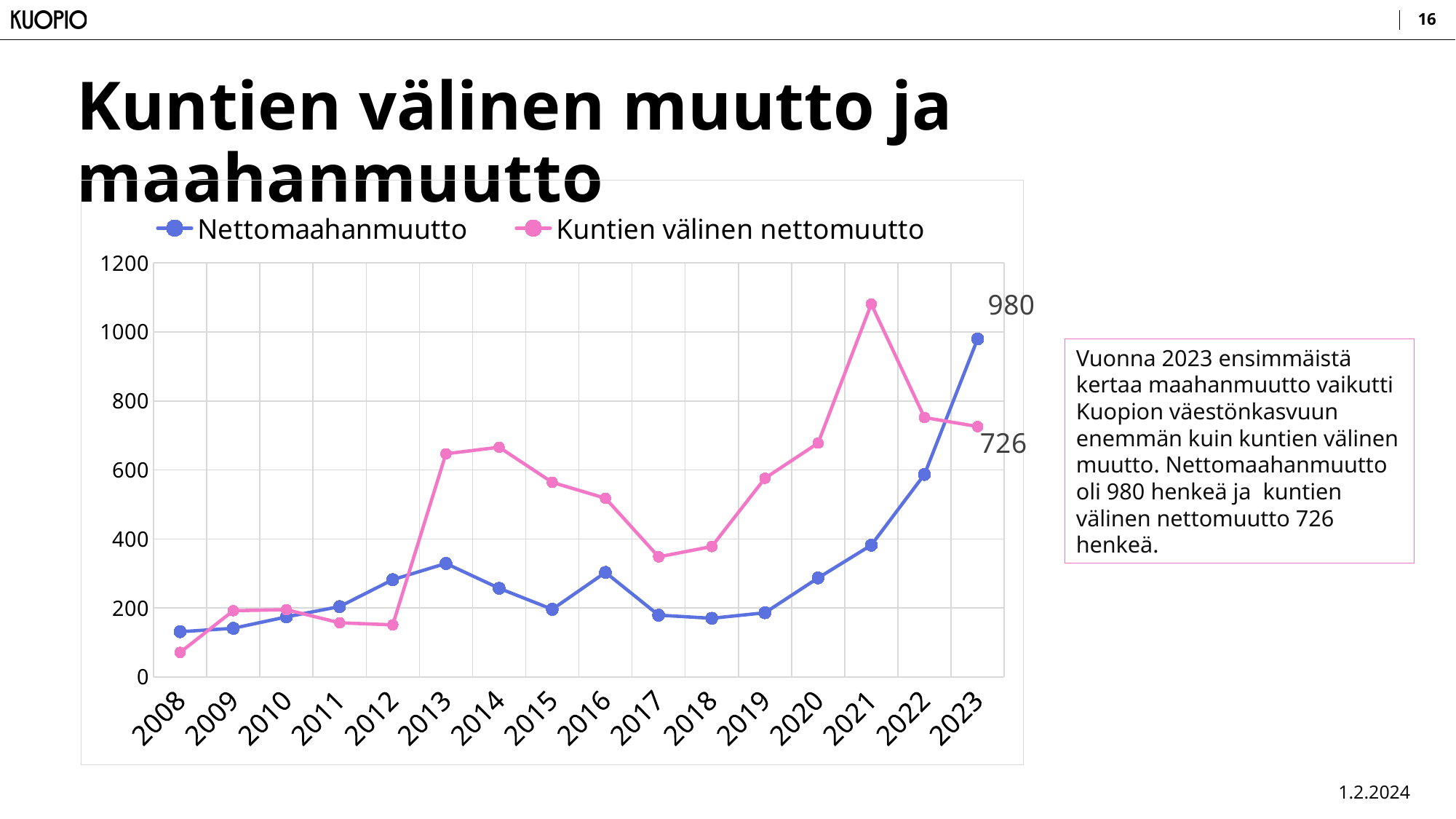
In 2023, which series has the larger value, Nettomaahanmuutto or Kuntien välinen nettomuutto? Nettomaahanmuutto What is the value of Nettomaahanmuutto in 2023? 980 In which year does Nettomaahanmuutto reach its highest value? 2023 How many series does the chart legend list? 2 In which year does Kuntien välinen nettomuutto reach its highest value? 2021 What is the difference between Nettomaahanmuutto and Kuntien välinen nettomuutto in 2023? 254 What kind of chart is shown on the slide? Line chart What is the value of Kuntien välinen nettomuutto in 2023? 726 How many years are shown on the x axis of the chart? 16 In which year is Kuntien välinen nettomuutto at its lowest? 2008 Is the value for Kuntien välinen nettomuutto in 2021 greater or less than 1000? greater Is the value for Nettomaahanmuutto in 2020 greater or less than 400? less